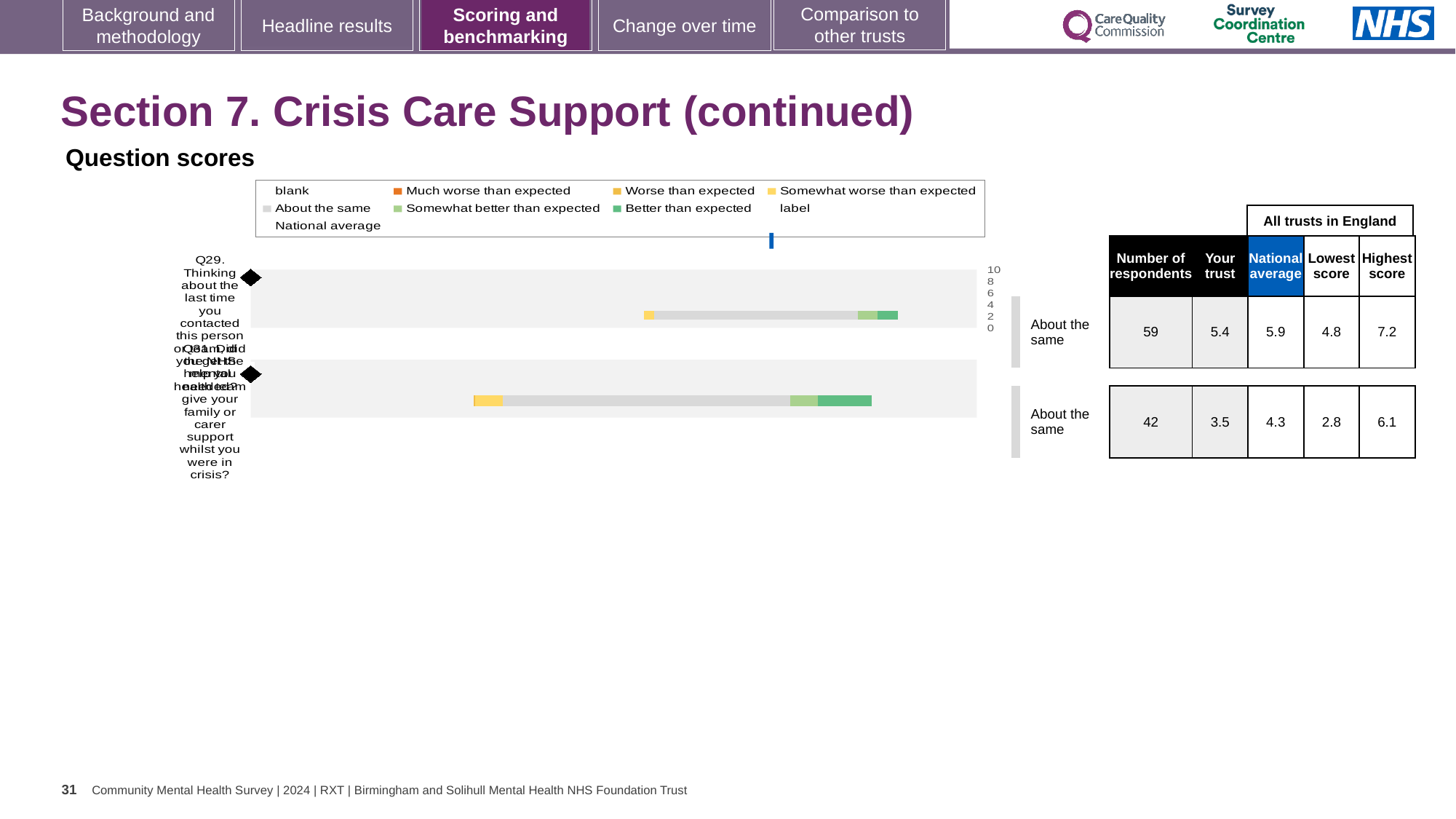
What colour does the legend use for 'Much worse than expected'? orange Which question has the higher 'Your trust' score, Q29 or Q31? Q29 For Q29, is the trust's score higher or lower than the national average? lower By how much does the national average exceed the trust's score for Q31? 0.8 What is the national average for Q31? 4.3 What kind of chart is shown under 'Question scores'? bar chart What is the heading above the chart? Question scores What is the difference between the highest and lowest scores for Q29? 2.4 How many questions are plotted in the chart? 2 What is the 'Your trust' score for Q29? 5.4 What is the lowest score among all trusts in England for Q31? 2.8 How many respondents answered Q29? 59